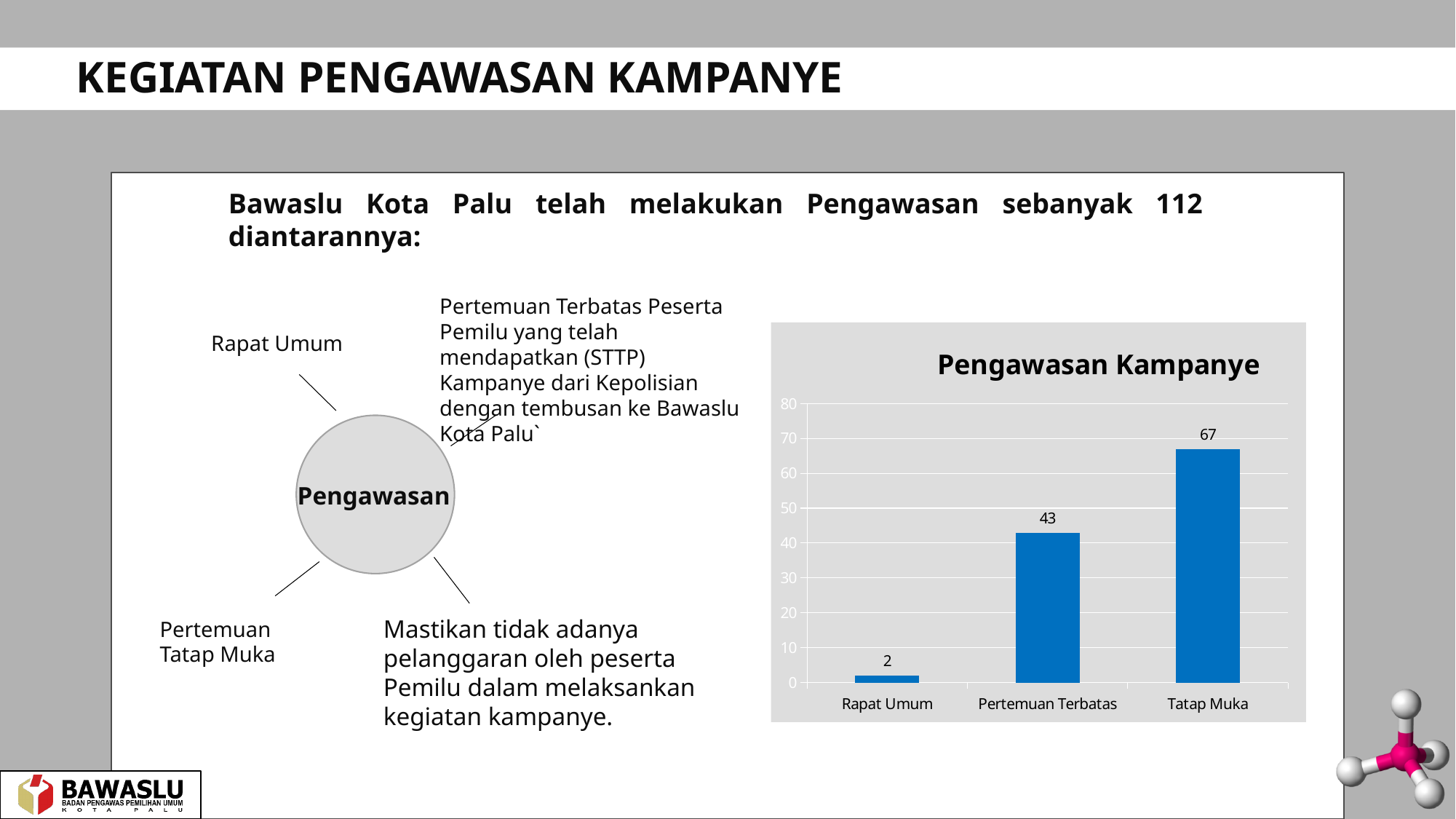
What is the value for Rapat Umum in the Pengawasan Kampanye chart? 2 What is the title of the chart on the slide? Pengawasan Kampanye Which is larger, the value for Pertemuan Terbatas or the value for Tatap Muka? Tatap Muka Is the value for Tatap Muka greater or less than 60? greater What is the value for Pertemuan Terbatas in the Pengawasan Kampanye chart? 43 Which category has the highest value in the Pengawasan Kampanye chart? Tatap Muka What is the difference between the values for Tatap Muka and Pertemuan Terbatas? 24 Which category has the lowest value in the Pengawasan Kampanye chart? Rapat Umum How many categories are shown in the Pengawasan Kampanye chart? 3 What kind of chart is the Pengawasan Kampanye chart? bar chart What is the value for Tatap Muka in the Pengawasan Kampanye chart? 67 What is the difference between the values for Pertemuan Terbatas and Rapat Umum? 41